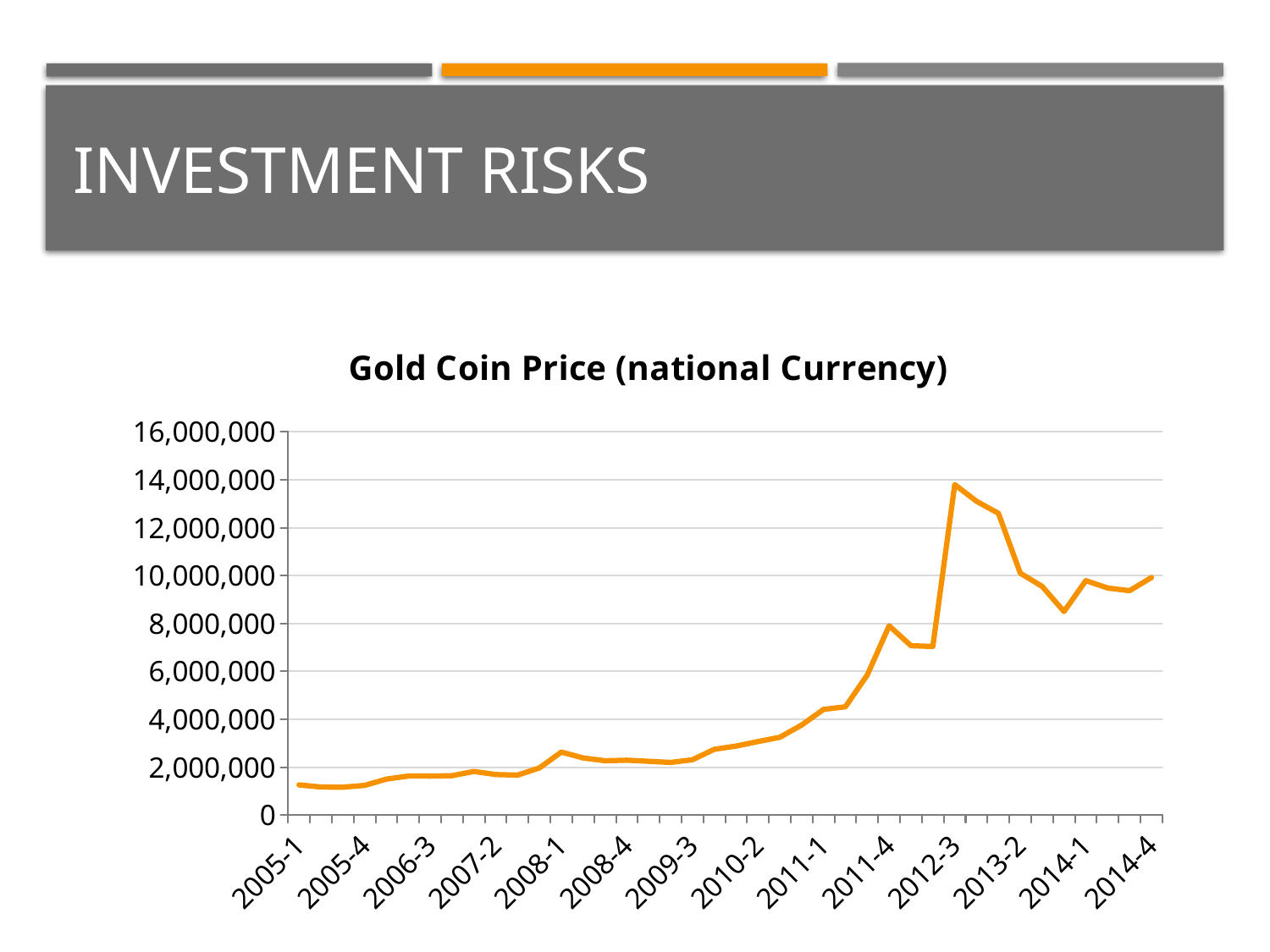
What is the highest value shown on the y axis? 16,000,000 Is the value for 2012-3 greater or less than 12,000,000? greater Is the value for 2005-1 greater or less than 2,000,000? less Overall, does the gold coin price rise or fall from 2005-1 to 2014-4? rise Is the value for 2010-2 greater or less than 4,000,000? less What is the title of the chart? Gold Coin Price (national Currency) What kind of chart is shown on the slide? line chart How many labels are shown on the x axis? 14 Which has the higher gold coin price, 2012-3 or 2014-4? 2012-3 At which labelled period does the gold coin price reach its highest point? 2012-3 Which has the higher gold coin price, 2005-1 or 2011-1? 2011-1